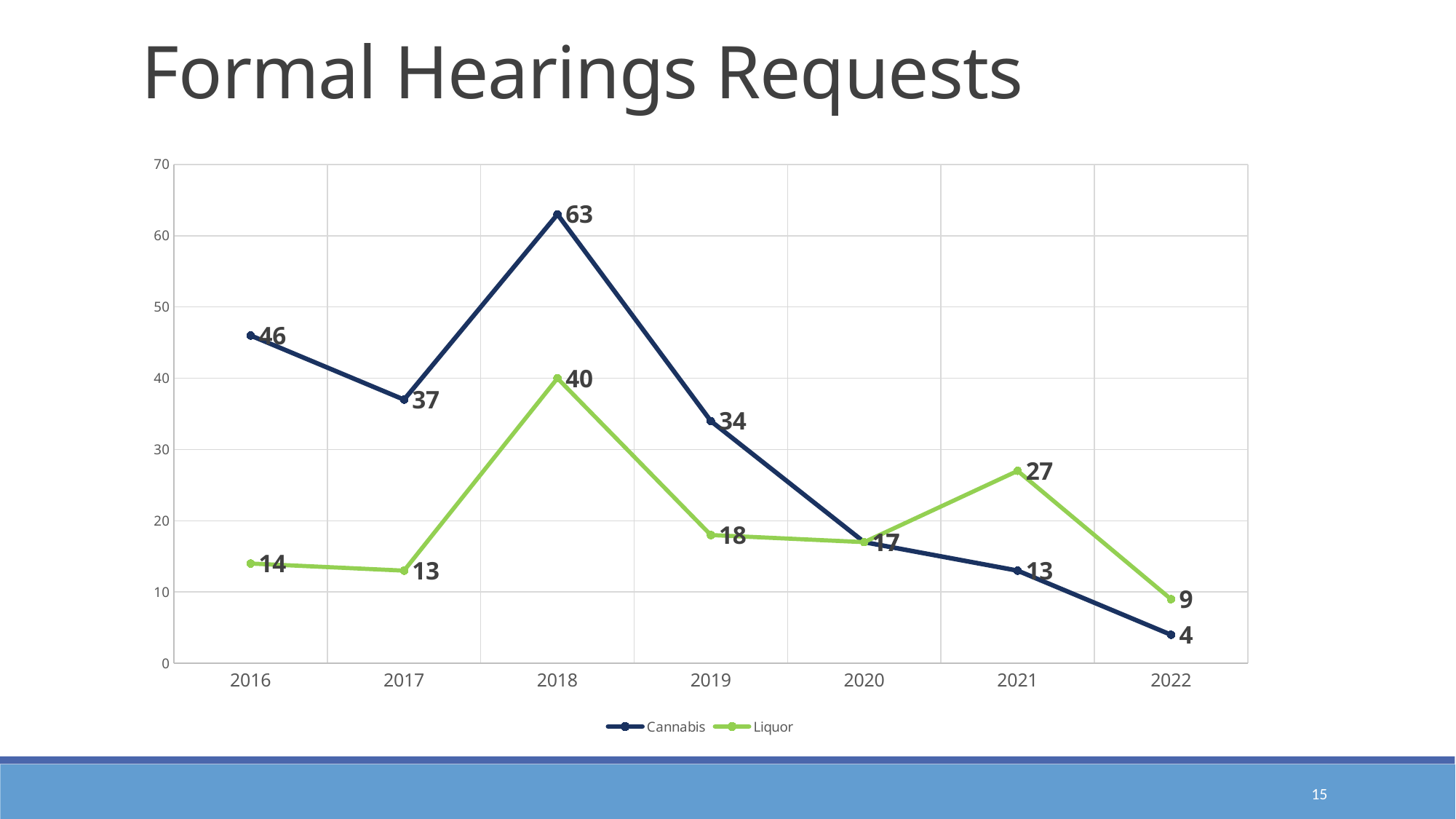
What is the Cannabis value for 2018? 63 Which series has the larger value in 2021, Cannabis or Liquor? Liquor In which year is the Liquor series lowest? 2022 How many years are shown on the x axis? 7 How many series does the legend list? 2 What is the Liquor value for 2021? 27 What is the title of the chart? Formal Hearings Requests In which year is the Cannabis series highest? 2018 What is the Cannabis value for 2022? 4 What kind of chart is shown on the slide? line chart Does the Cannabis series rise or fall from 2018 to 2022? fall What is the difference between the Cannabis and Liquor values in 2018? 23